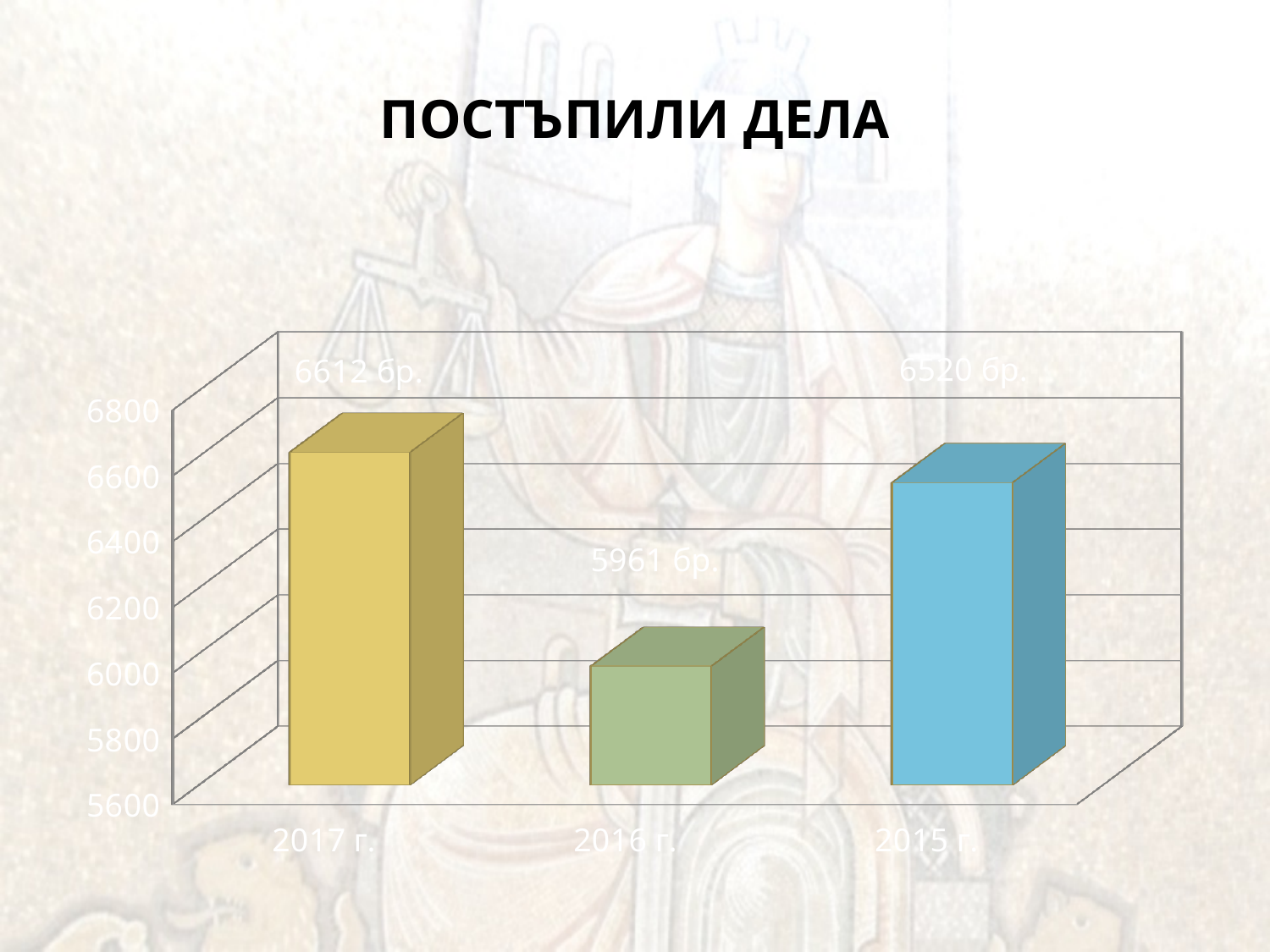
What is the title of the slide? ПОСТЪПИЛИ ДЕЛА Which year has the lowest value? 2016 г. What is the value for 2017 г.? 6612 бр. Which year has the highest value? 2017 г. What is the value for 2015 г.? 6520 бр. How many categories are shown on the chart? 3 What is the difference between the values for 2015 г. and 2016 г.? 559 бр. What is the value for 2016 г.? 5961 бр. What is the difference between the values for 2017 г. and 2015 г.? 92 бр. What kind of chart is shown on the slide? bar chart Which is larger, the value for 2016 г. or the value for 2015 г.? 2015 г. Is the value for 2016 г. greater or less than 6000? less